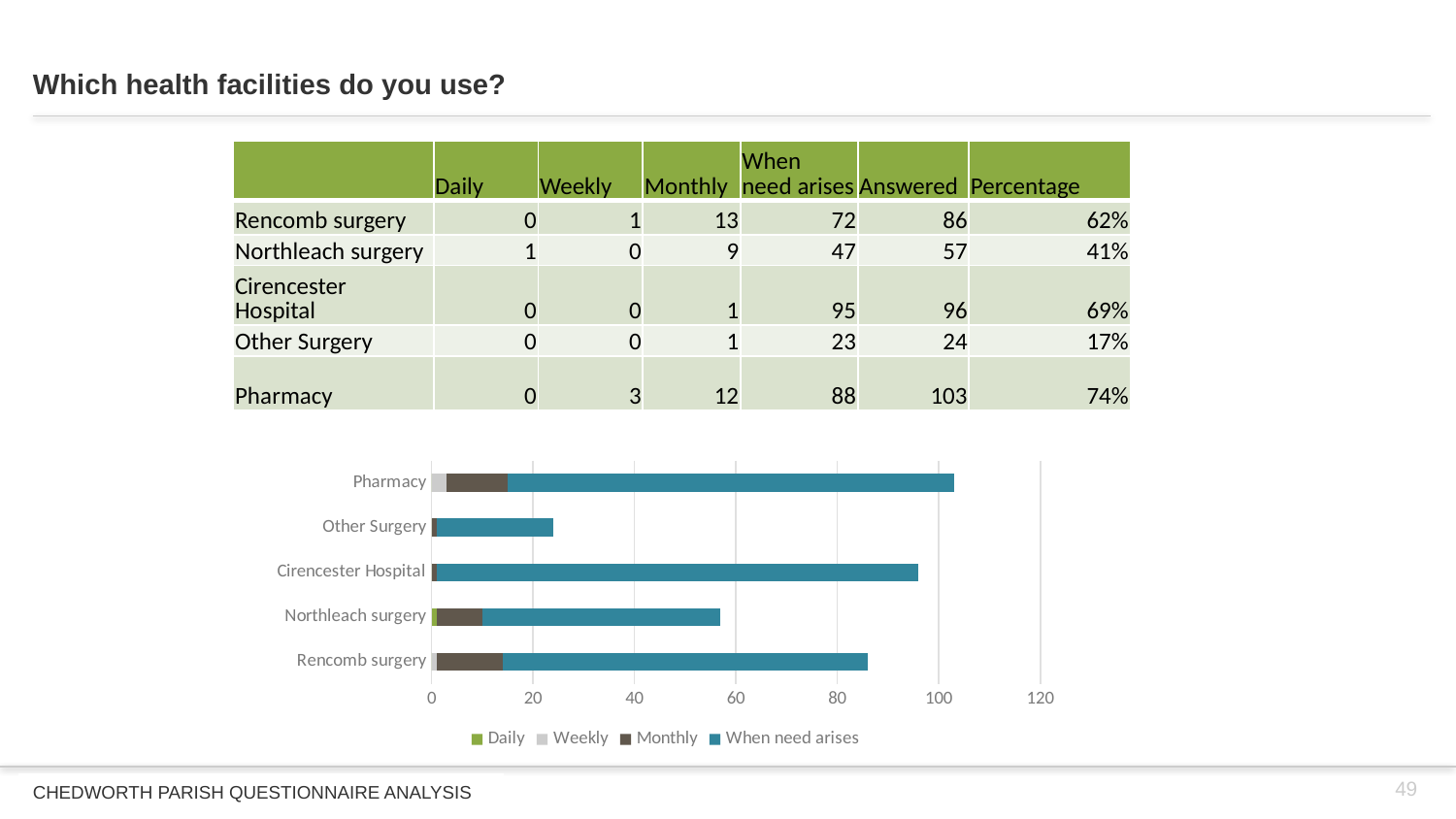
What kind of chart is shown on the slide? bar chart Which series is shown in the largest segment of each bar, according to the legend? When need arises What is the difference between the total for Pharmacy and the total for Rencomb surgery? 17 What is the 'Monthly' value for Pharmacy? 12 How many series does the chart legend list? 4 Which health facility has the shortest stacked bar? Other Surgery Is the total bar length for Cirencester Hospital greater or less than 80? greater What is the total of the stacked bar for Northleach surgery? 57 What is the 'When need arises' value for Rencomb surgery? 72 How many health facilities are listed on the chart's vertical axis? 5 Is the total bar length for Other Surgery greater or less than 40? less Which health facility has the longest stacked bar? Pharmacy